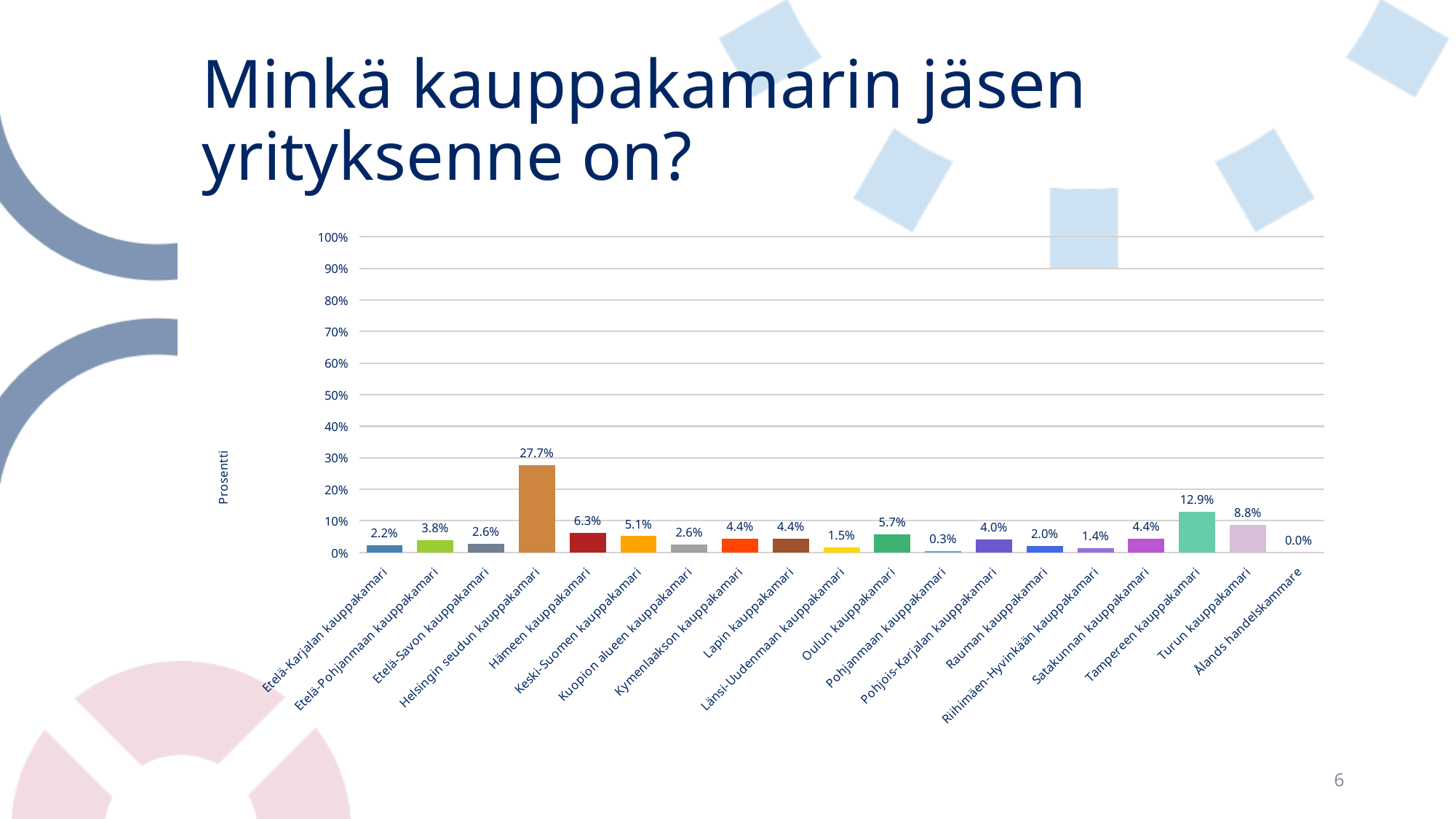
Which category has the highest value? Helsingin seudun kauppakamari What kind of chart is shown on the slide? bar chart What is the value for Turun kauppakamari? 8.8% What is the value for Pohjanmaan kauppakamari? 0.3% How many categories are shown on the x axis? 19 Is the value for Helsingin seudun kauppakamari greater or less than 20%? greater What is the label on the vertical axis? Prosentti Which is larger, the value for Hämeen kauppakamari or the value for Oulun kauppakamari? Hämeen kauppakamari Which category has the lowest value? Ålands handelskammare What is the value for Helsingin seudun kauppakamari? 27.7% What is the difference between the values for Helsingin seudun kauppakamari and Tampereen kauppakamari? 14.8% What is the value for Tampereen kauppakamari? 12.9%